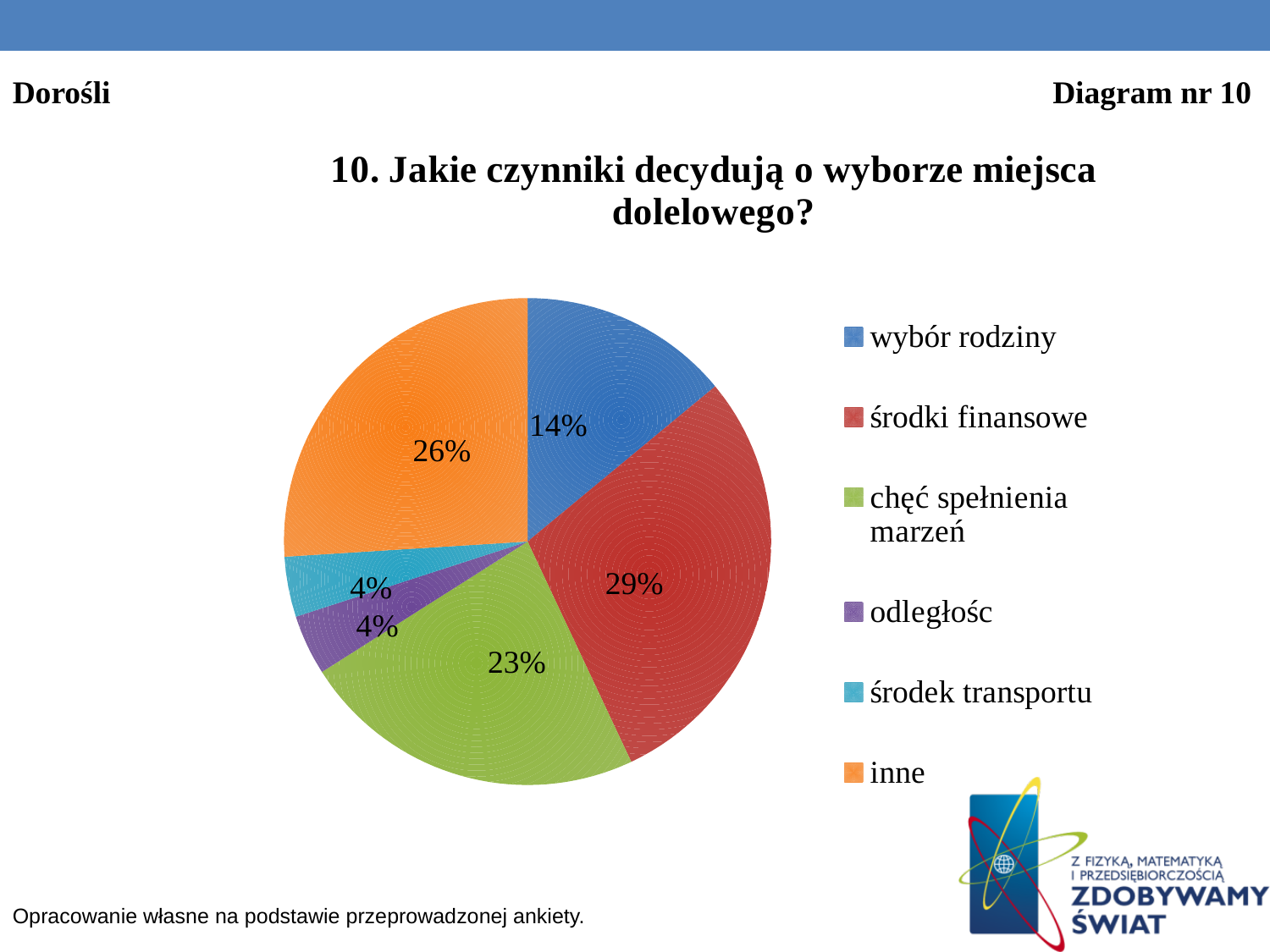
What kind of chart is shown on the slide? pie chart What colour is the slice for "inne"? orange What share of the pie does "inne" have? 26% Which category has the largest slice of the pie? środki finansowe What share of the pie does "chęć spełnienia marzeń" have? 23% How many categories does the legend list? 6 What share of the pie does "wybór rodziny" have? 14% What is the title of the chart? 10. Jakie czynniki decydują o wyborze miejsca dolelowego? Which is larger, the share for "inne" or the share for "chęć spełnienia marzeń"? inne What is the difference in percentage points between "środki finansowe" and "wybór rodziny"? 15